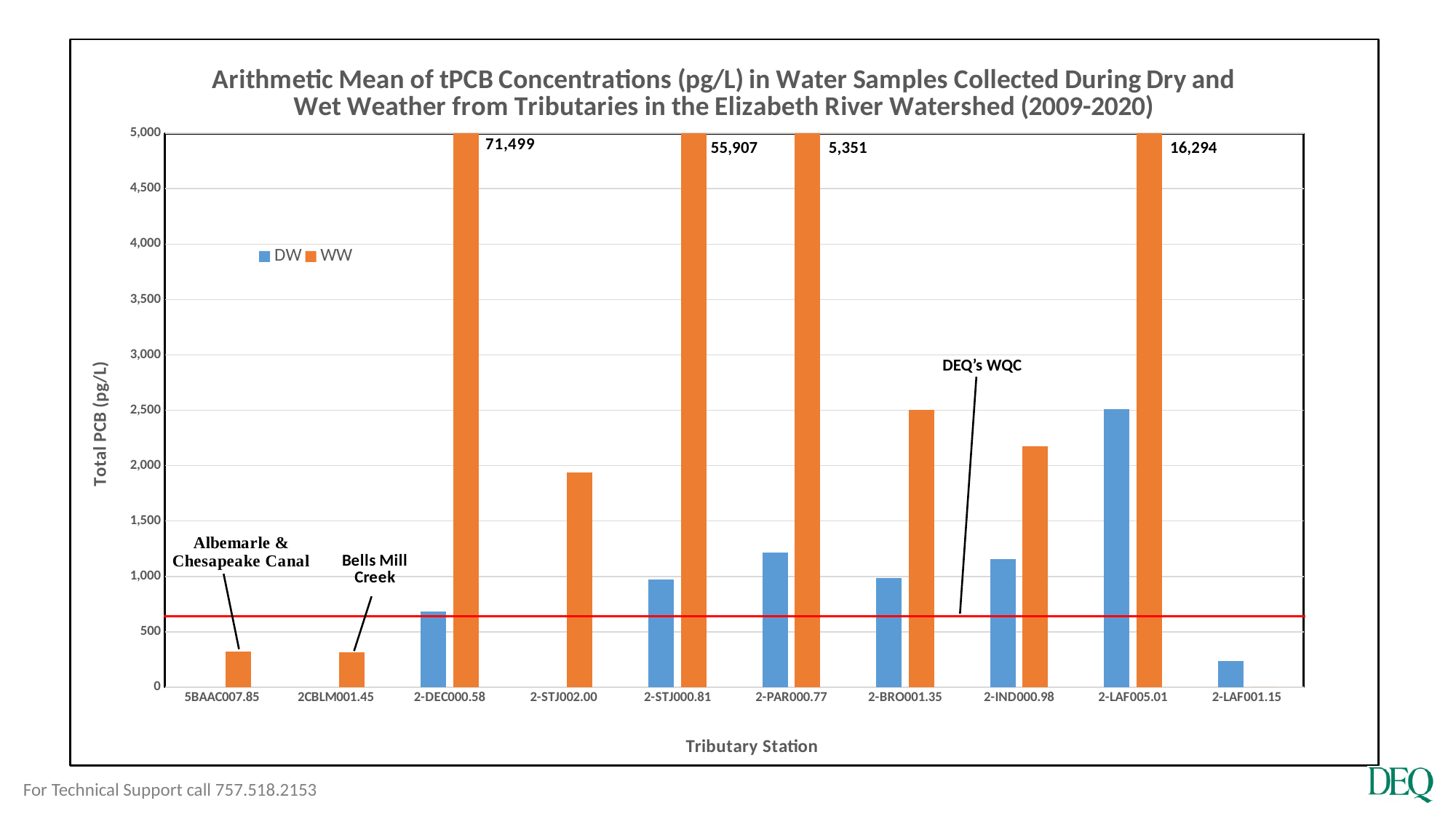
What type of chart is shown on the slide? Bar chart Is the DW value for 2-LAF005.01 greater or less than 2,000? greater How many series does the legend list? 2 Which station has the highest DW value? 2-LAF005.01 What is the WW value for station 2-DEC000.58? 71,499 How many tributary stations are shown on the x axis? 10 What is the WW value for station 2-LAF005.01? 16,294 What is the WW value for station 2-STJ000.81? 55,907 What does the label on the red horizontal line say? DEQ's WQC What is the difference between the WW values for 2-DEC000.58 and 2-STJ000.81? 15,592 What is the WW value for station 2-PAR000.77? 5,351 Which station has the highest WW value? 2-DEC000.58